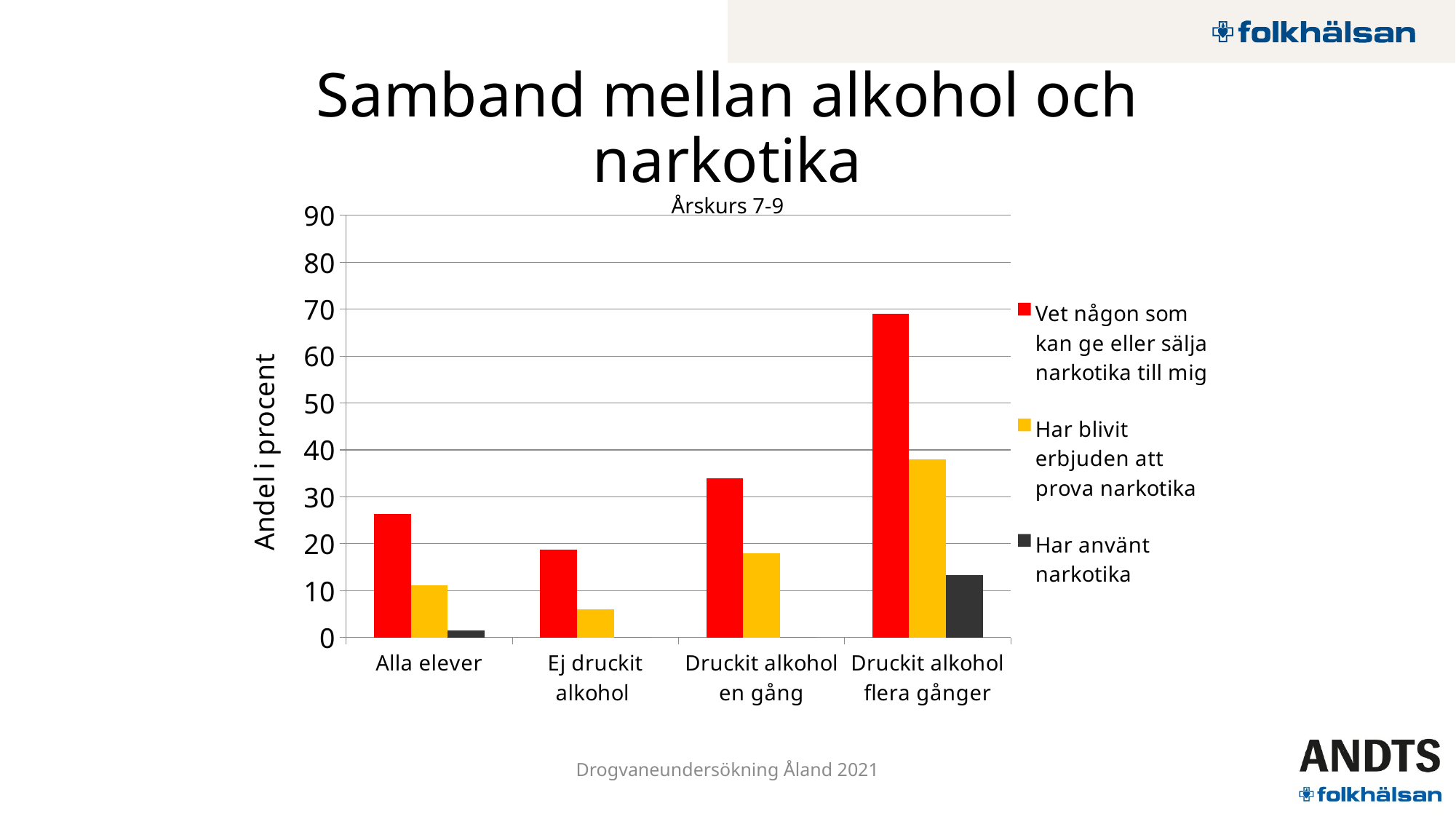
Which has a larger value for 'Vet någon som kan ge eller sälja narkotika till mig': 'Druckit alkohol en gång' or 'Alla elever'? Druckit alkohol en gång What is the label on the chart's vertical axis? Andel i procent How many series does the chart's legend list? 3 What is the title shown above the chart's plot area? Årskurs 7-9 What kind of chart is shown on the slide? bar chart Which category has the lowest value for 'Vet någon som kan ge eller sälja narkotika till mig'? Ej druckit alkohol Which category has the highest value for 'Vet någon som kan ge eller sälja narkotika till mig'? Druckit alkohol flera gånger Is the value for 'Vet någon som kan ge eller sälja narkotika till mig' in the 'Alla elever' category greater or less than 30? less Is the value for 'Har använt narkotika' in the 'Druckit alkohol flera gånger' category greater or less than 10? greater Is the value for 'Vet någon som kan ge eller sälja narkotika till mig' in the 'Druckit alkohol flera gånger' category greater or less than 60? greater How many categories are shown on the x axis of the chart? 4